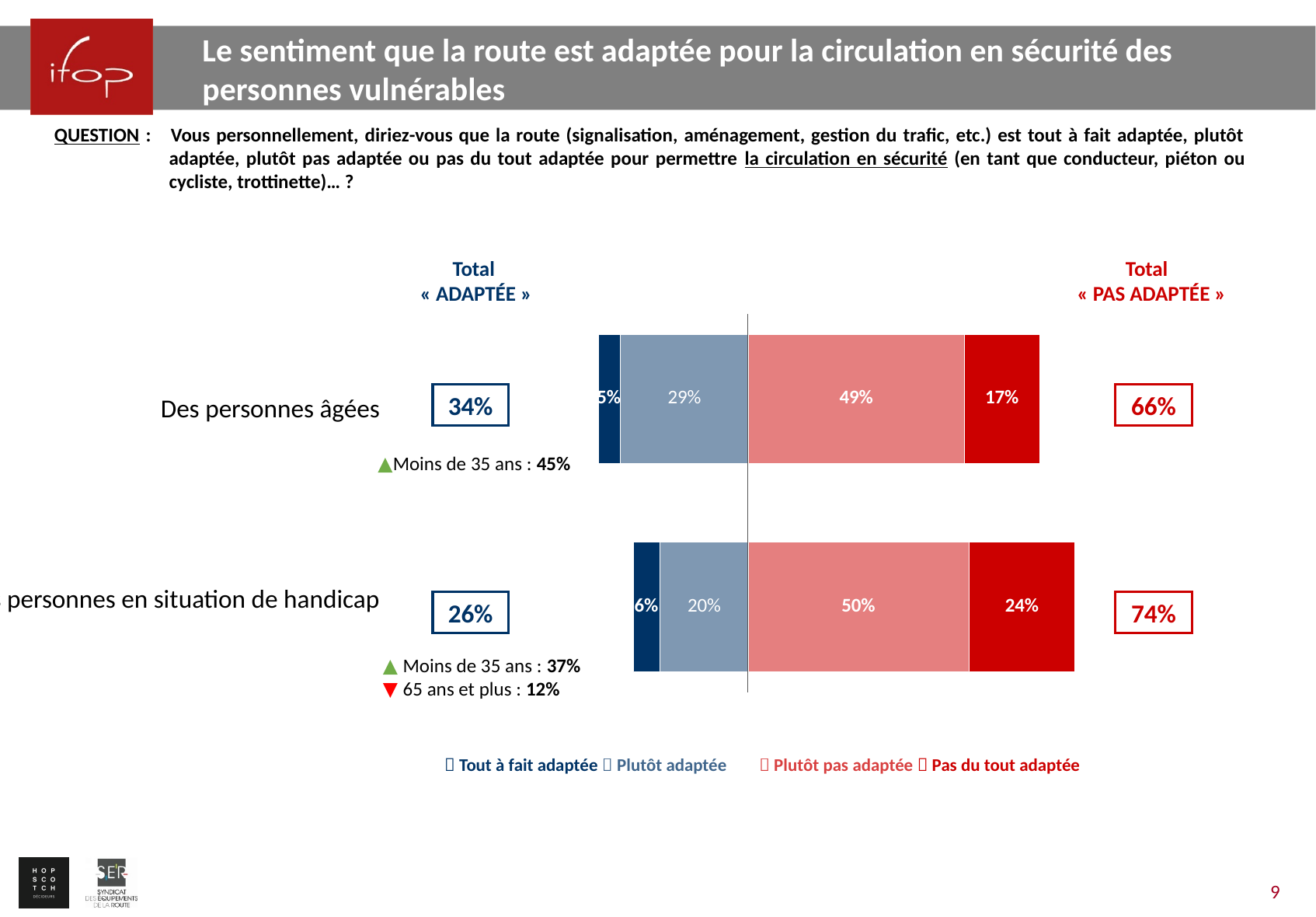
What is the "Plutôt adaptée" value for "personnes en situation de handicap"? 20% What kind of chart is shown on the slide? Stacked bar chart What is the difference between the Total « PAS ADAPTÉE » values for the two categories (74% and 66%)? 8 percentage points What is the "Pas du tout adaptée" value for the "personnes en situation de handicap" bar? 24% What is the Total « PAS ADAPTÉE » value shown for "personnes en situation de handicap"? 74% What is the Total « ADAPTÉE » value shown for "Des personnes âgées"? 34% What percentage of respondents answered "Plutôt pas adaptée" for "Des personnes âgées"? 49% What is the Total « ADAPTÉE » value among respondents under 35 ("Moins de 35 ans") for "Des personnes âgées"? 45% How many series does the legend list? 4 What is the difference between the "Plutôt adaptée" values for "Des personnes âgées" (29%) and "personnes en situation de handicap" (20%)? 9 percentage points Which category has the higher "Pas du tout adaptée" value, "Des personnes âgées" or "personnes en situation de handicap"? personnes en situation de handicap How many categories (bars) are shown in the chart? 2